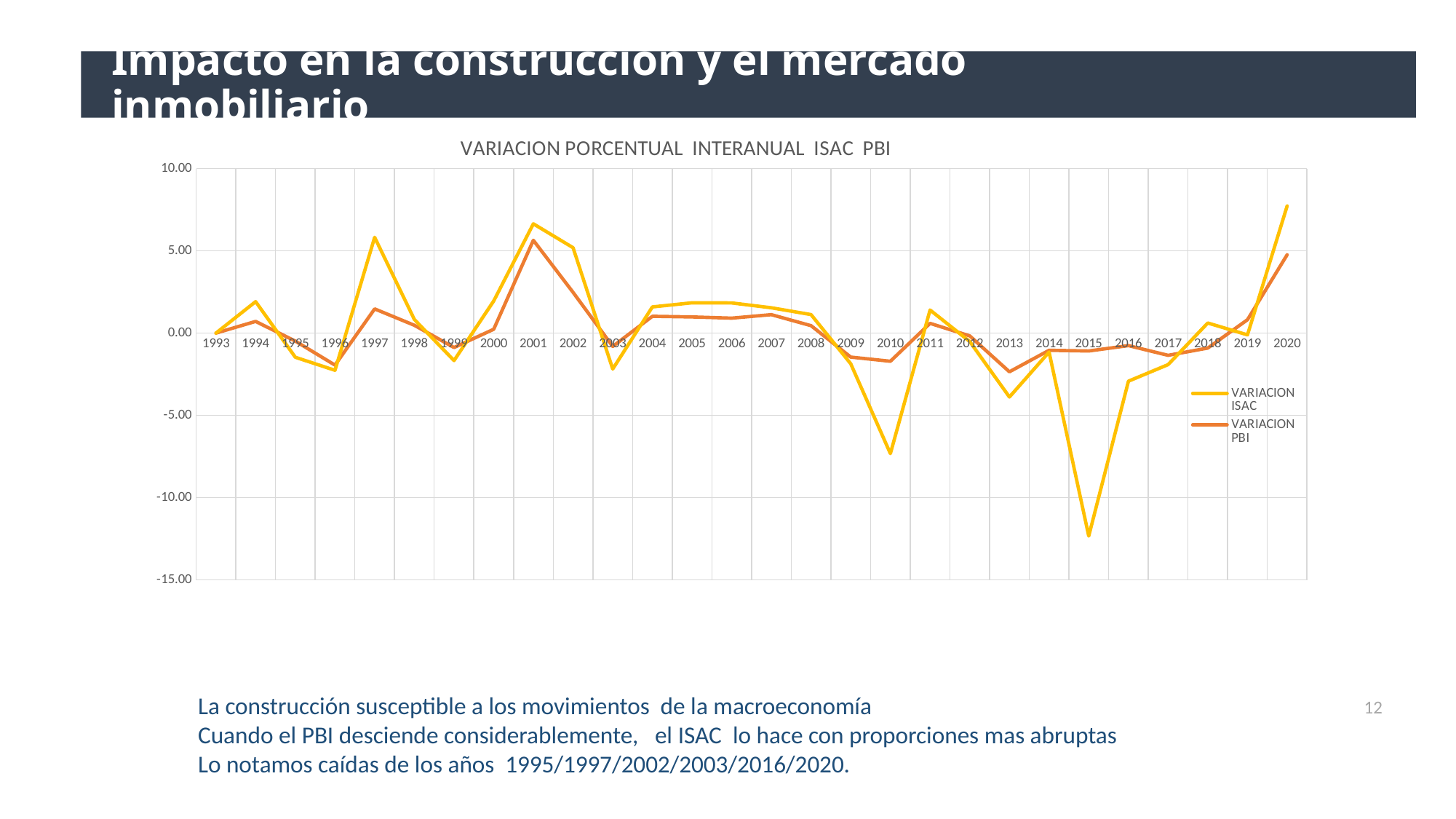
In which year does the VARIACION ISAC series reach its highest value? 2020 In which year does the VARIACION ISAC series reach its lowest value? 2015 In 2015, which series has the larger value, VARIACION ISAC or VARIACION PBI? VARIACION PBI Is the VARIACION ISAC value for 2020 greater or less than 5.00? greater What is the title of the chart? VARIACION PORCENTUAL INTERANUAL ISAC PBI How many years are plotted along the x axis? 28 How many series does the legend list? 2 Is the VARIACION ISAC value for 2010 greater or less than -5.00? less Is the VARIACION ISAC value for 2015 greater or less than -10.00? less What are the two series named in the legend? VARIACION ISAC and VARIACION PBI What kind of chart is shown on the slide? line chart In which year does the VARIACION PBI series reach its highest value? 2001